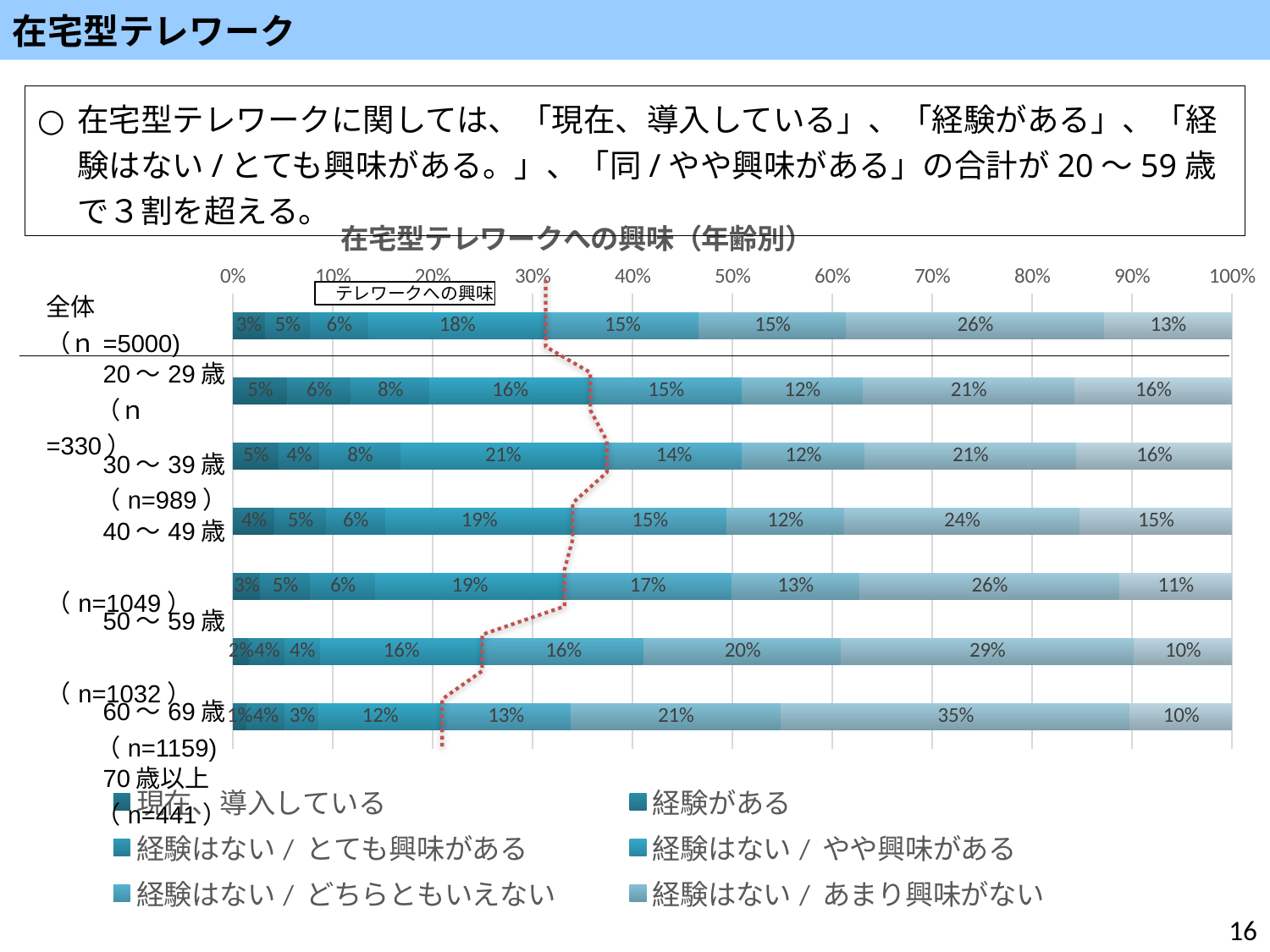
What is the value of 「経験はない / どちらともいえない」 for 70歳以上? 13% Which has the larger 「経験はない / あまり興味がない」 value: 50～59歳 or 60～69歳? 60～69歳 What kind of chart is shown on the slide? Stacked bar chart For 全体, what is the combined total of 「現在、導入している」, 「経験がある」, 「経験はない / とても興味がある」 and 「経験はない / やや興味がある」? 32% Which age group has the highest value for 「経験はない / やや興味がある」? 30～39歳 How much larger is the 「経験はない / やや興味がある」 value for 全体 than for 70歳以上? 6 percentage points What is the value of 「経験がある」 for 40～49歳? 5% How many age-group bars (including 全体) are plotted in the chart? 7 Which age group has the lowest value for 「現在、導入している」? 70歳以上 What is the value of 「経験はない / とても興味がある」 for 20～29歳? 8% What is the title of the chart? 在宅型テレワークへの興味（年齢別） What is the value of 「経験はない / やや興味がある」 for 全体 (n=5000)? 18%